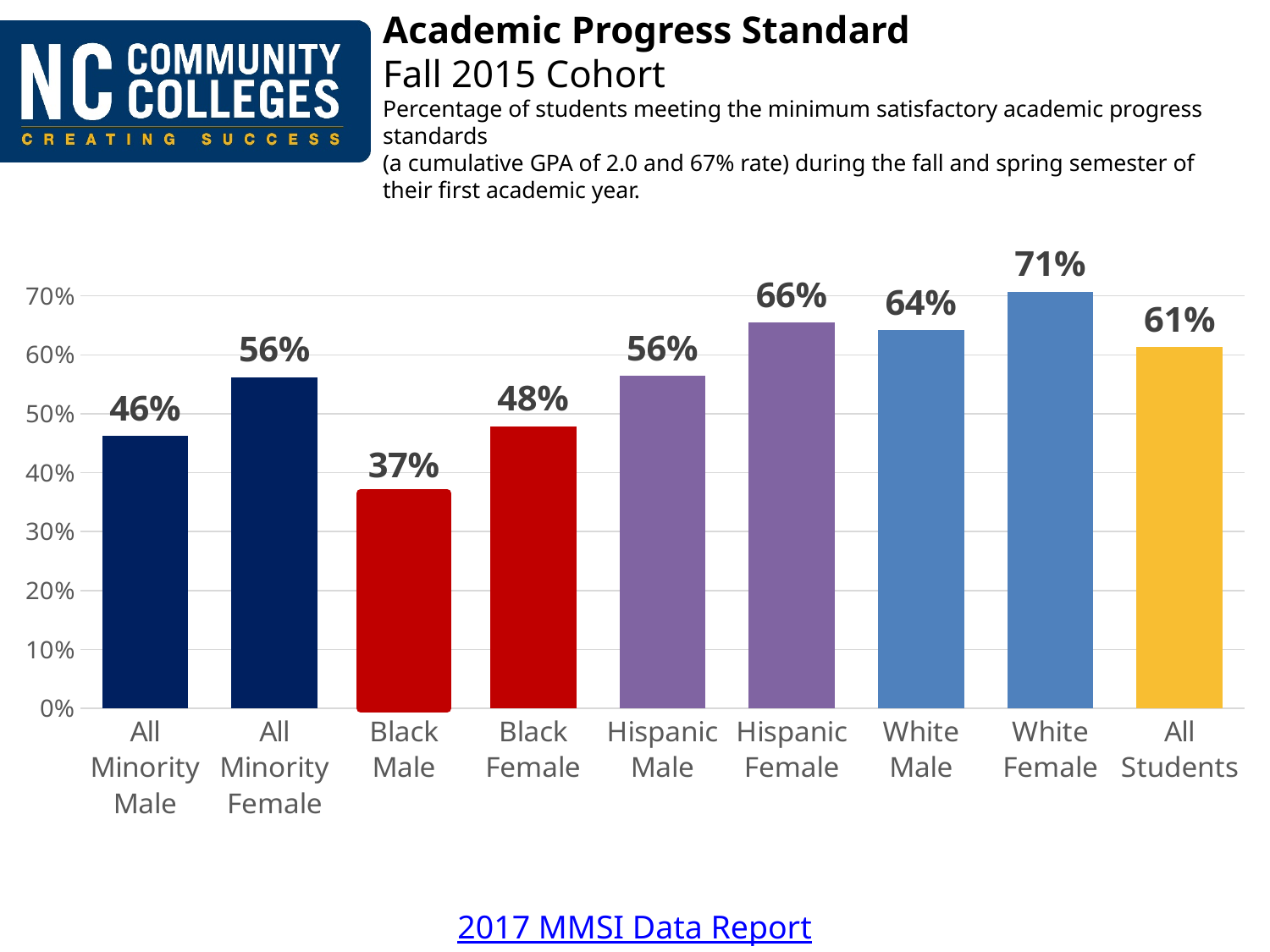
What is the difference between the White Female and Black Male percentages? 34% What is the value shown for All Students? 61% Which is larger, the value for White Male or the value for Hispanic Female? Hispanic Female What percentage is shown for Hispanic Female students? 66% What kind of chart is shown on the slide? Bar chart Which category has the highest percentage? White Female What is the title of the chart? Academic Progress Standard How many categories are shown on the x axis? 9 Which category has the lowest percentage? Black Male What percentage of Black Male students met the academic progress standard? 37% Is the value for Black Female greater or less than 50%? less What is the difference between the All Minority Female and All Minority Male percentages? 10%